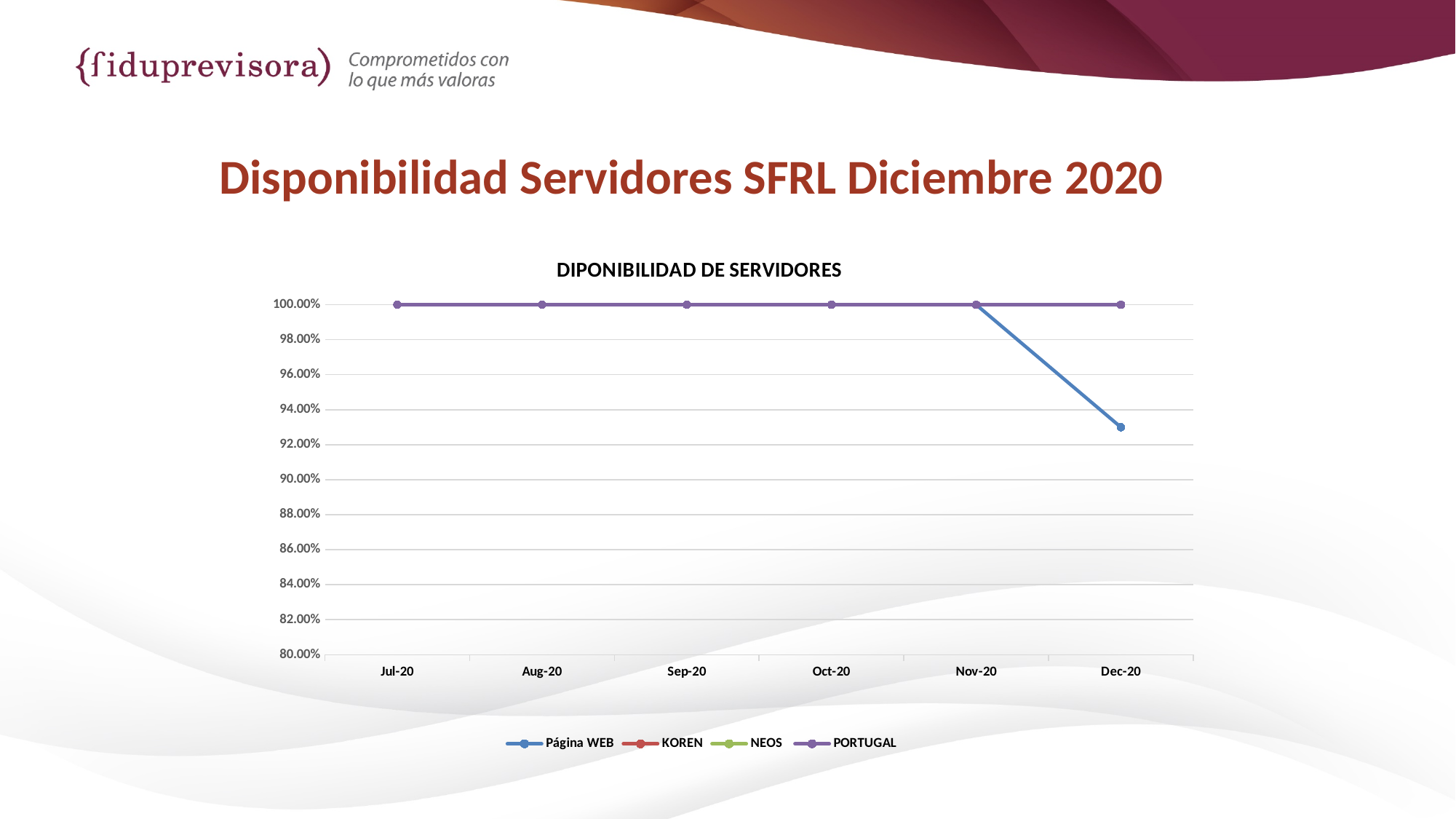
Is the value for Página WEB in Dec-20 greater or less than 94.00%? less Which legend entry is shown in blue? Página WEB How many series does the chart legend list? 4 What is the value for Página WEB in Nov-20? 100.00% How many months are shown on the x axis of the chart? 6 What kind of chart is shown on the slide? line chart Does the Página WEB line rise or fall between Nov-20 and Dec-20? fall What is the value for PORTUGAL in Dec-20? 100.00% In Dec-20, which is larger: the value for PORTUGAL or the value for Página WEB? PORTUGAL Is the value for Página WEB in Dec-20 greater or less than 92.00%? greater Which series has the lowest value in Dec-20? Página WEB What is the title of the chart? DIPONIBILIDAD DE SERVIDORES